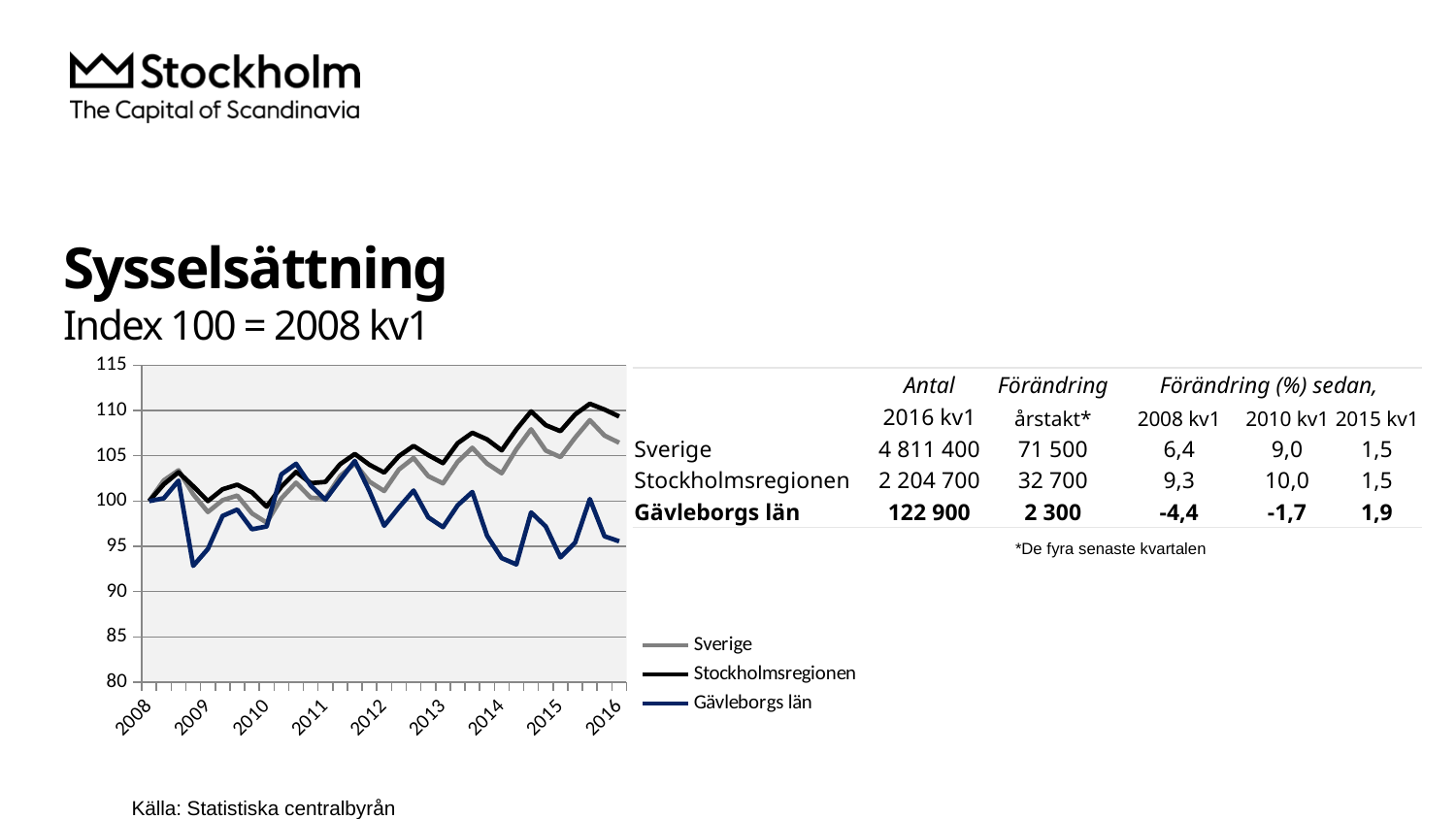
Which series has the highest value at the end of the chart in 2016? Stockholmsregionen Does the Gävleborgs län series rise or fall overall from 2008 to 2016? fall What is the title of the chart? Sysselsättning Is the value for Stockholmsregionen in 2016 greater or less than 105? greater Which series has the lowest value at the end of the chart in 2016? Gävleborgs län Is the value for Gävleborgs län in 2016 greater or less than 100? less Which is larger in 2016, the value for Stockholmsregionen or the value for Gävleborgs län? Stockholmsregionen How many series does the chart's legend list? 3 Does the Stockholmsregionen series rise or fall overall from 2008 to 2016? rise What kind of chart is shown on the slide? line chart Is the value for Sverige in 2016 greater or less than 100? greater Which series are listed in the chart's legend? Sverige, Stockholmsregionen, Gävleborgs län